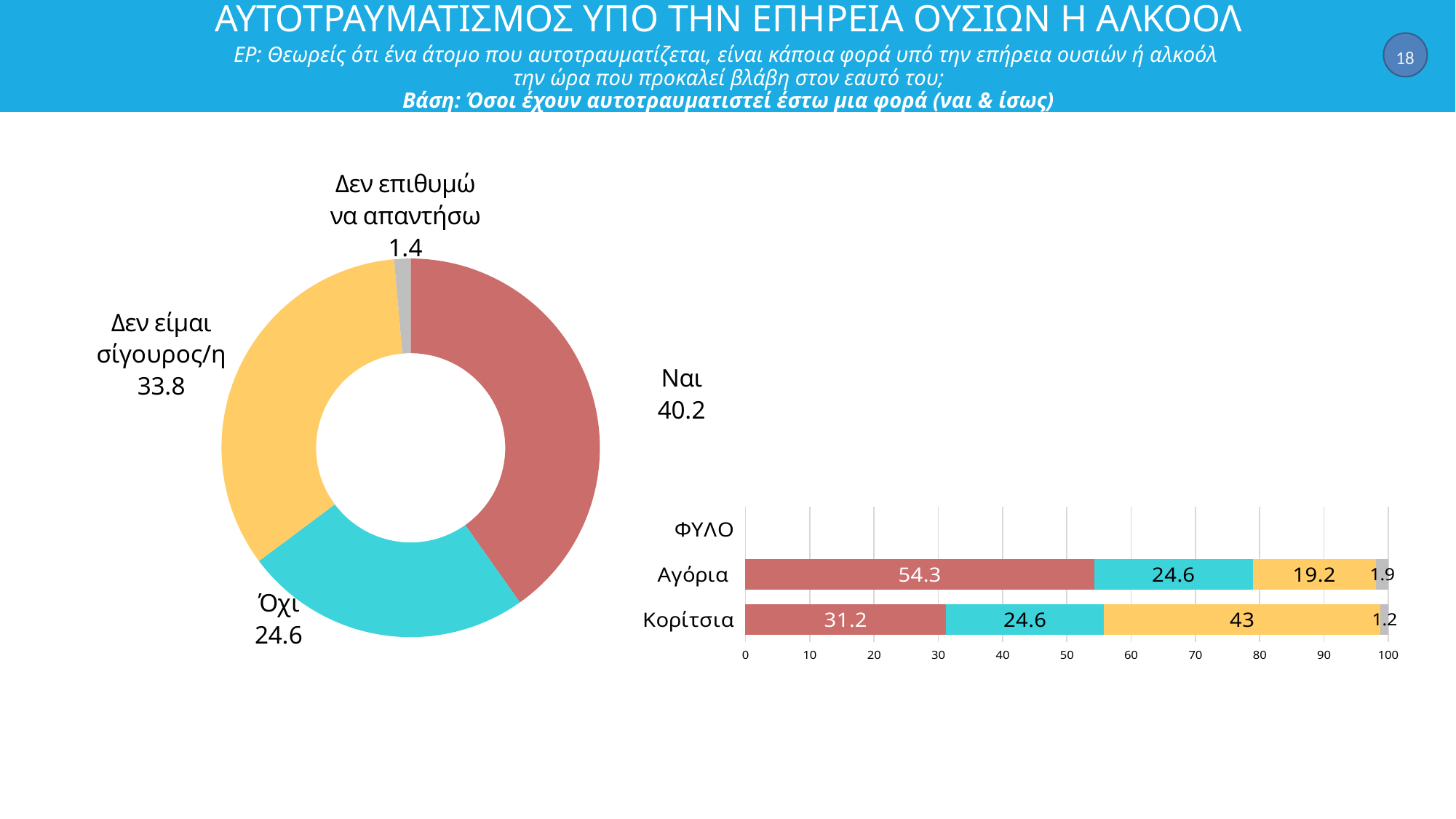
In the ΦΥΛΟ bar chart on the right, what is the difference between the red segment values for Αγόρια and Κορίτσια? 23.1 How many categories does the donut chart on the left show? 4 In the donut chart on the left, which category has the largest share? Ναι In the ΦΥΛΟ bar chart on the right, what is the total of the Κορίτσια bar? 100 In the donut chart on the left, which category has the smallest share? Δεν επιθυμώ να απαντήσω In the ΦΥΛΟ bar chart on the right, what is the value of the red segment for Αγόρια? 54.3 In the ΦΥΛΟ bar chart on the right, which group has the larger red segment, Αγόρια or Κορίτσια? Αγόρια In the donut chart on the left, what is the difference between the values for Ναι and Όχι? 15.6 In the ΦΥΛΟ bar chart on the right, what is the value of the yellow segment for Κορίτσια? 43 In the donut chart on the left, what is the value for Δεν είμαι σίγουρος/η? 33.8 In the donut chart on the left, what is the value for Ναι? 40.2 What kind of chart is the ΦΥΛΟ chart on the right? Stacked bar chart